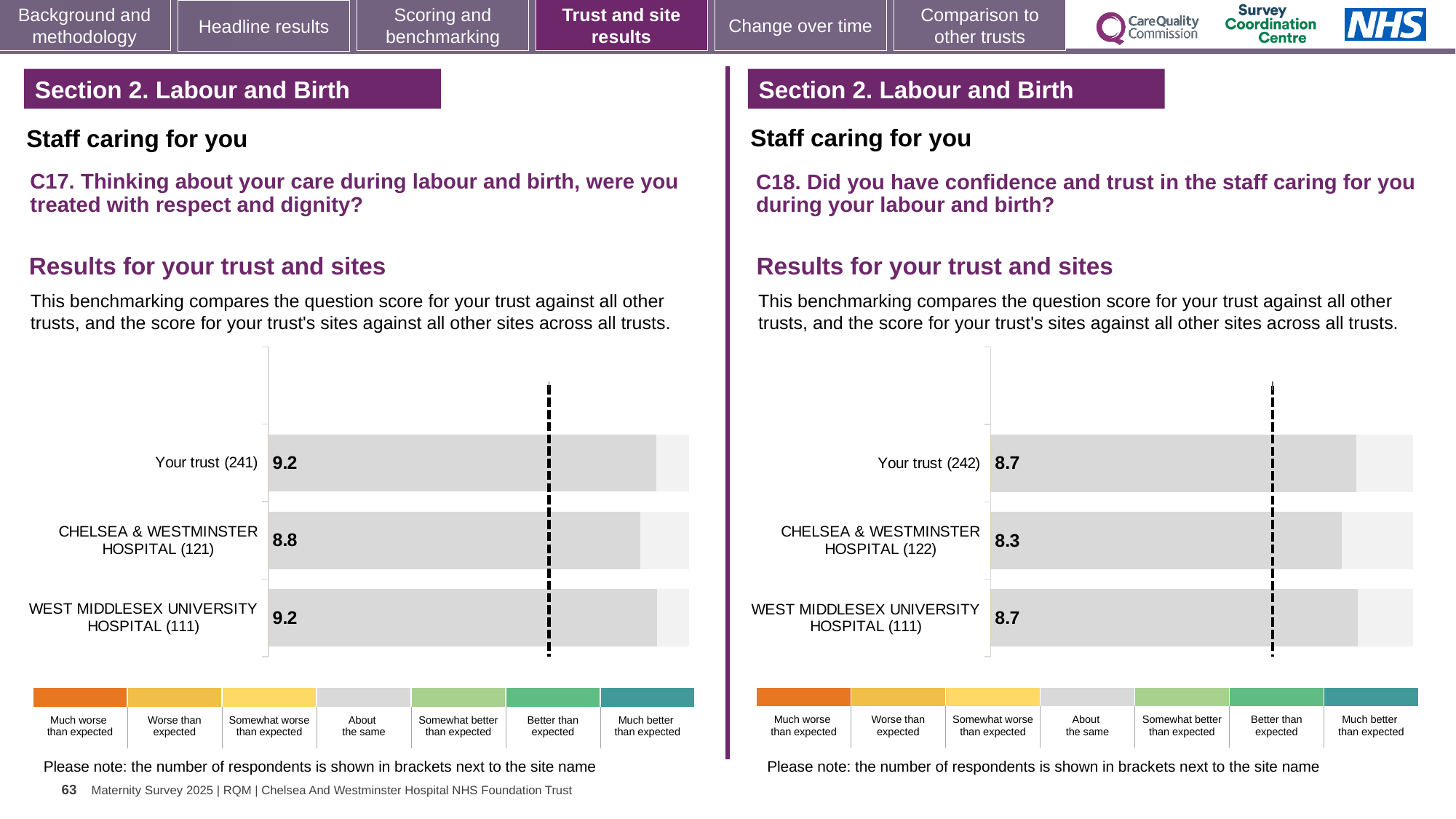
In the C18 chart on the right, what is the score for WEST MIDDLESEX UNIVERSITY HOSPITAL (111)? 8.7 How many bars are shown in the C17 chart on the left? 3 In the C18 chart on the right, which site has the lowest score? CHELSEA & WESTMINSTER HOSPITAL (122) How many respondents are shown in brackets for Your trust in the C18 chart on the right? 242 In the C17 chart on the left, which site has the lowest score? CHELSEA & WESTMINSTER HOSPITAL (121) In the C17 chart on the left, what is the score for CHELSEA & WESTMINSTER HOSPITAL (121)? 8.8 In the C18 chart on the right, what is the score for CHELSEA & WESTMINSTER HOSPITAL (122)? 8.3 In the C18 chart on the right, what is the difference between the score for WEST MIDDLESEX UNIVERSITY HOSPITAL (111) and CHELSEA & WESTMINSTER HOSPITAL (122)? 0.4 What kind of chart is used in the C18 chart on the right? Bar chart In the C18 chart on the right, which has the higher score: Your trust (242) or CHELSEA & WESTMINSTER HOSPITAL (122)? Your trust (242) In the C17 chart on the left, what is the difference between the score for Your trust (241) and CHELSEA & WESTMINSTER HOSPITAL (121)? 0.4 In the C17 chart on the left, what is the score for Your trust (241)? 9.2